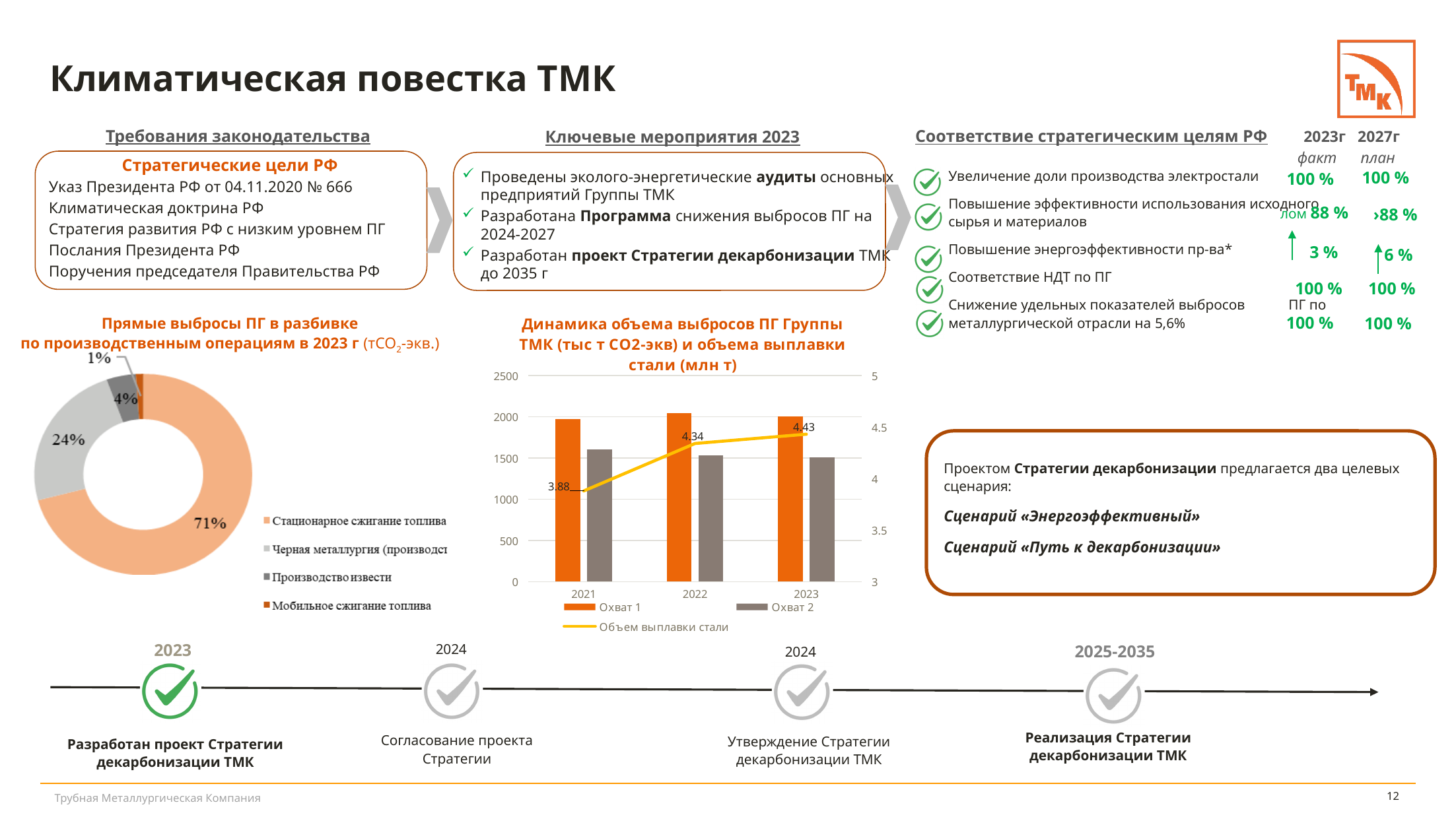
In the pie chart "Прямые выбросы ПГ в разбивке по производственным операциям в 2023 г", which category has the smallest share? Мобильное сжигание топлива In the pie chart "Прямые выбросы ПГ в разбивке по производственным операциям в 2023 г", what share does "Производство извести" have? 4% In the chart "Динамика объема выбросов ПГ Группы ТМК", what is the value of "Объем выплавки стали" for 2023? 4.43 In the chart "Динамика объема выбросов ПГ Группы ТМК", does "Объем выплавки стали" rise or fall from 2021 to 2023? Rises What kind of chart is the chart titled "Прямые выбросы ПГ в разбивке по производственным операциям в 2023 г"? Pie (donut) chart In the pie chart "Прямые выбросы ПГ в разбивке по производственным операциям в 2023 г", what share does "Стационарное сжигание топлива" have? 71% In the chart "Динамика объема выбросов ПГ Группы ТМК", by how much did "Объем выплавки стали" change from 2021 (3.88) to 2023 (4.43)? 0.55 In the chart "Динамика объема выбросов ПГ Группы ТМК", what is the value of "Объем выплавки стали" for 2021? 3.88 In the chart "Динамика объема выбросов ПГ Группы ТМК", how many series does the legend list? 3 In the pie chart "Прямые выбросы ПГ в разбивке по производственным операциям в 2023 г", how many categories are shown? 4 In the chart "Динамика объема выбросов ПГ Группы ТМК", is the "Охват 2" bar for 2021 greater or less than 1500? greater In the pie chart "Прямые выбросы ПГ в разбивке по производственным операциям в 2023 г", what is the difference in percentage points between the largest slice (71%) and the 24% slice? 47